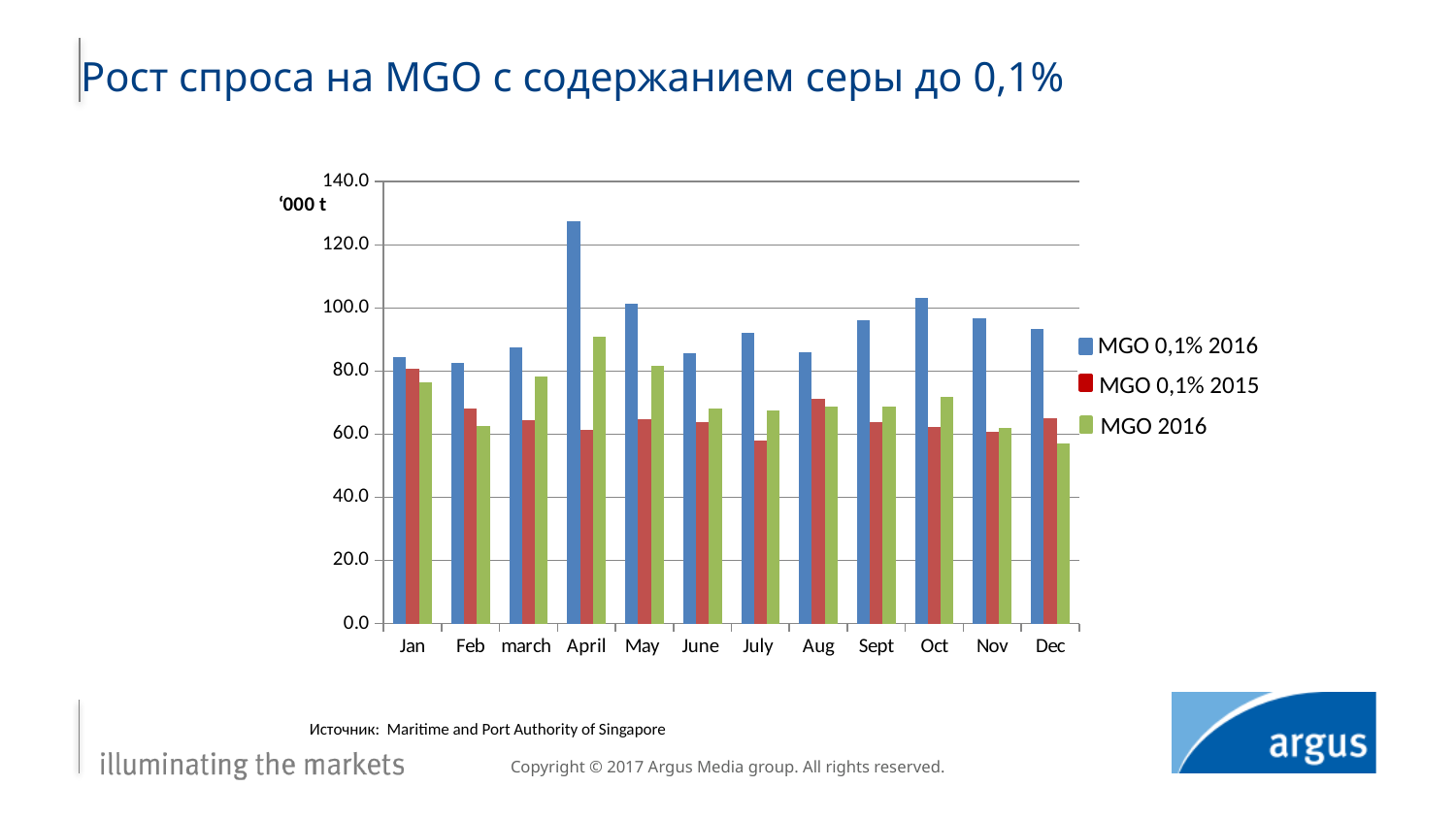
In which month is the value for MGO 0,1% 2016 highest? April What kind of chart is shown on the slide? bar chart In which month is the value for MGO 2016 lowest? Dec How many series does the legend list? 3 Is the value for MGO 0,1% 2015 in July greater or less than 60? less Is the value for MGO 0,1% 2016 in Oct greater or less than 100? greater What unit is shown on the y axis of the chart? '000 t How many months are shown along the x axis? 12 Which is larger in Oct: MGO 0,1% 2016 or MGO 0,1% 2015? MGO 0,1% 2016 Is the value for MGO 0,1% 2016 in April greater or less than 120? greater In which month is the value for MGO 0,1% 2015 lowest? July Which is larger in April: MGO 0,1% 2016 or MGO 2016? MGO 0,1% 2016